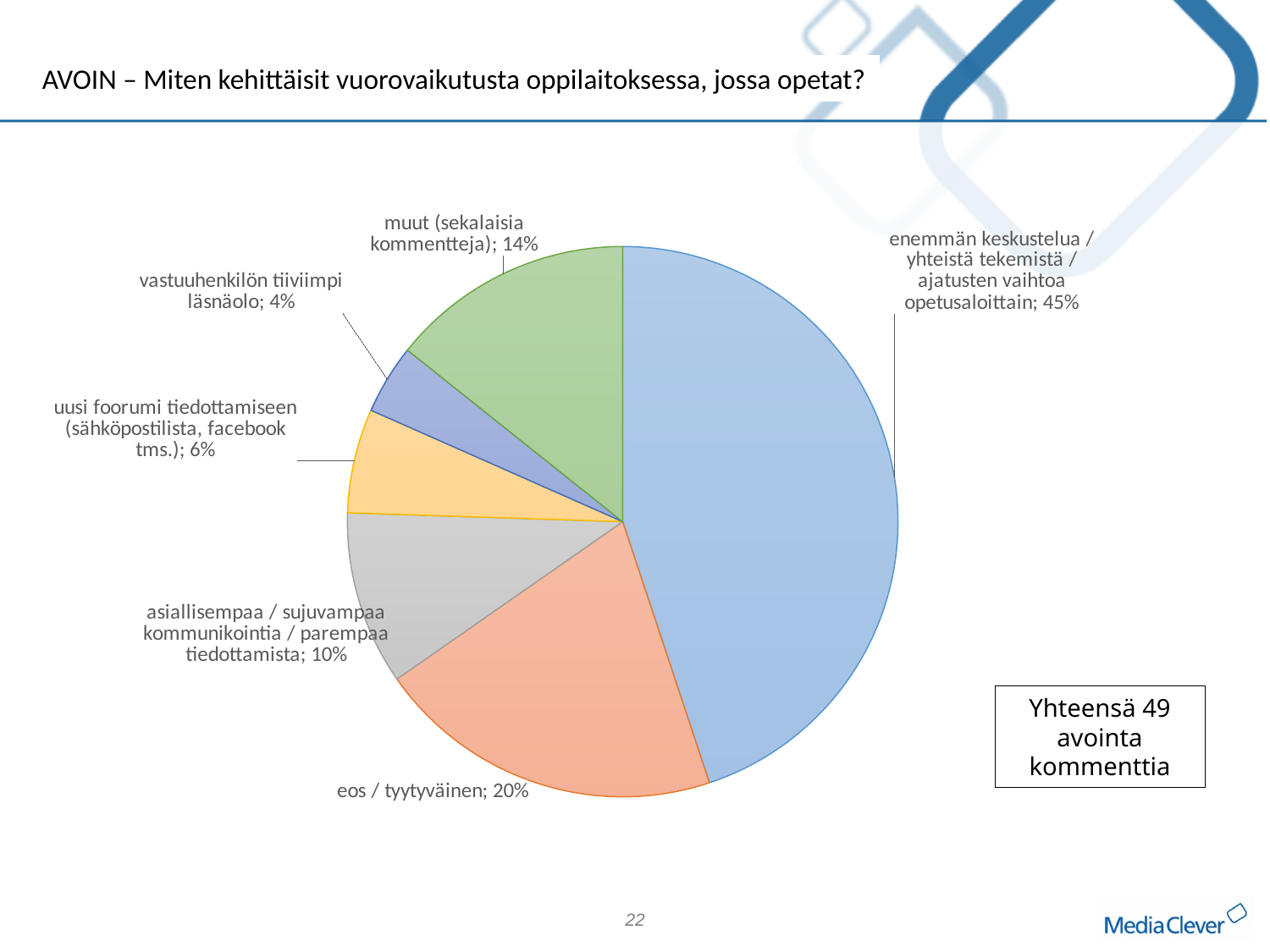
Which category has the largest slice of the pie? enemmän keskustelua / yhteistä tekemistä / ajatusten vaihtoa opetusaloittain According to the text box on the slide, how many open comments were there in total? 49 Which category has the smallest slice of the pie? vastuuhenkilön tiiviimpi läsnäolo What share of the pie does "muut (sekalaisia kommentteja)" have? 14% What share of the pie does "enemmän keskustelua / yhteistä tekemistä / ajatusten vaihtoa opetusaloittain" have? 45% What kind of chart is shown on the slide? pie chart What share of the pie does "vastuuhenkilön tiiviimpi läsnäolo" have? 4% What share of the pie does "eos / tyytyväinen" have? 20% What is the difference in percentage points between "eos / tyytyväinen" and "asiallisempaa / sujuvampaa kommunikointia / parempaa tiedottamista"? 10 How many categories (slices) does the pie chart have? 6 What share of the pie does "uusi foorumi tiedottamiseen (sähköpostilista, facebook tms.)" have? 6% Which is larger: the share for "muut (sekalaisia kommentteja)" or the share for "asiallisempaa / sujuvampaa kommunikointia / parempaa tiedottamista"? muut (sekalaisia kommentteja)